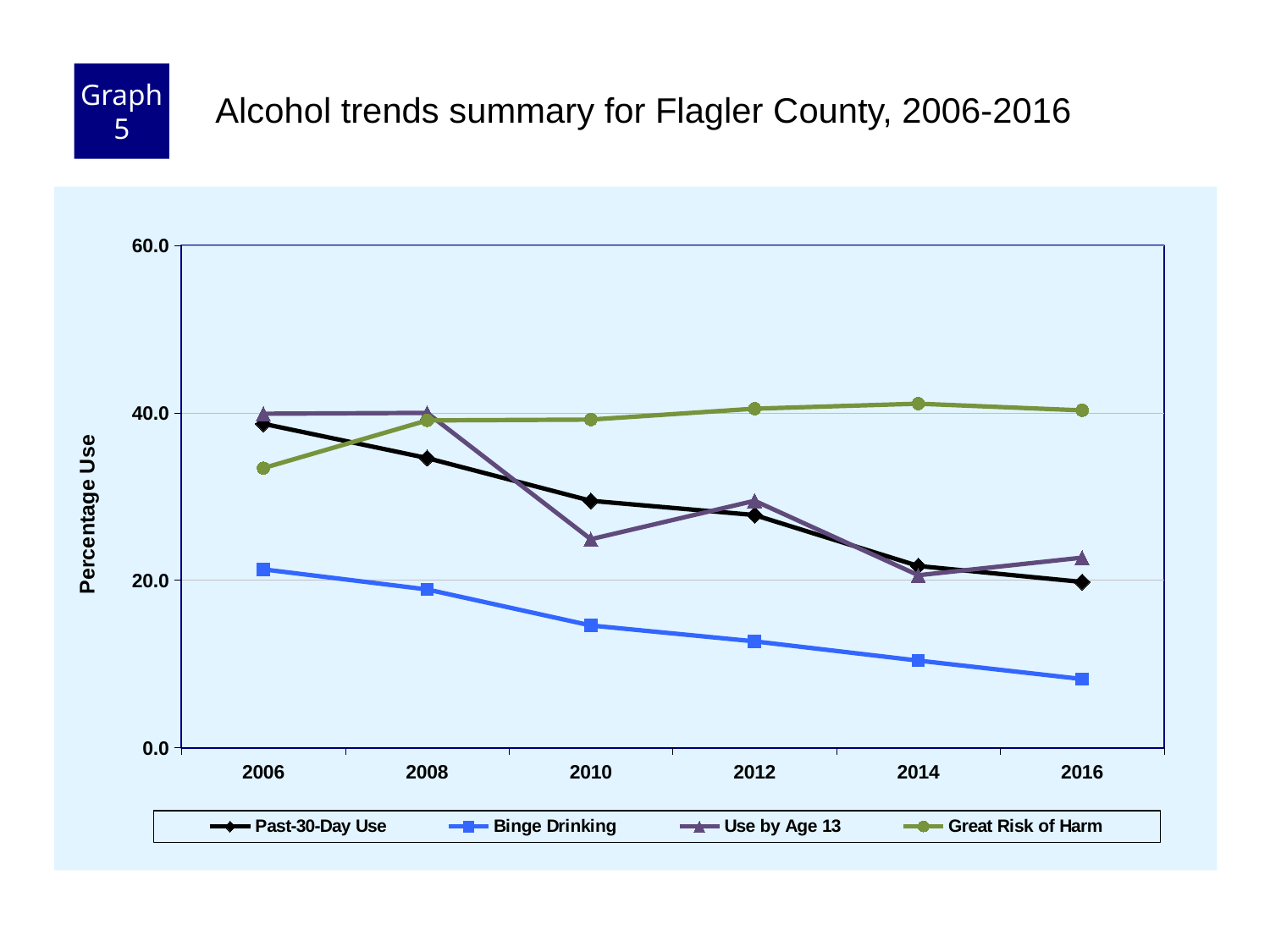
Does the Past-30-Day Use line rise or fall from 2006 to 2016? fall Is the value for Great Risk of Harm in 2006 greater or less than 40.0? less In 2006, which is larger: Use by Age 13 or Great Risk of Harm? Use by Age 13 Does the Binge Drinking line rise or fall from 2006 to 2016? fall Which series has the lowest value in 2016? Binge Drinking What kind of chart is shown on the slide? line chart Is the value for Use by Age 13 in 2010 greater or less than 20.0? greater What is the label on the y axis? Percentage Use Is the value for Binge Drinking in 2016 greater or less than 20.0? less How many series does the legend list? 4 How many years are plotted along the x axis? 6 Which series has the highest value in 2016? Great Risk of Harm